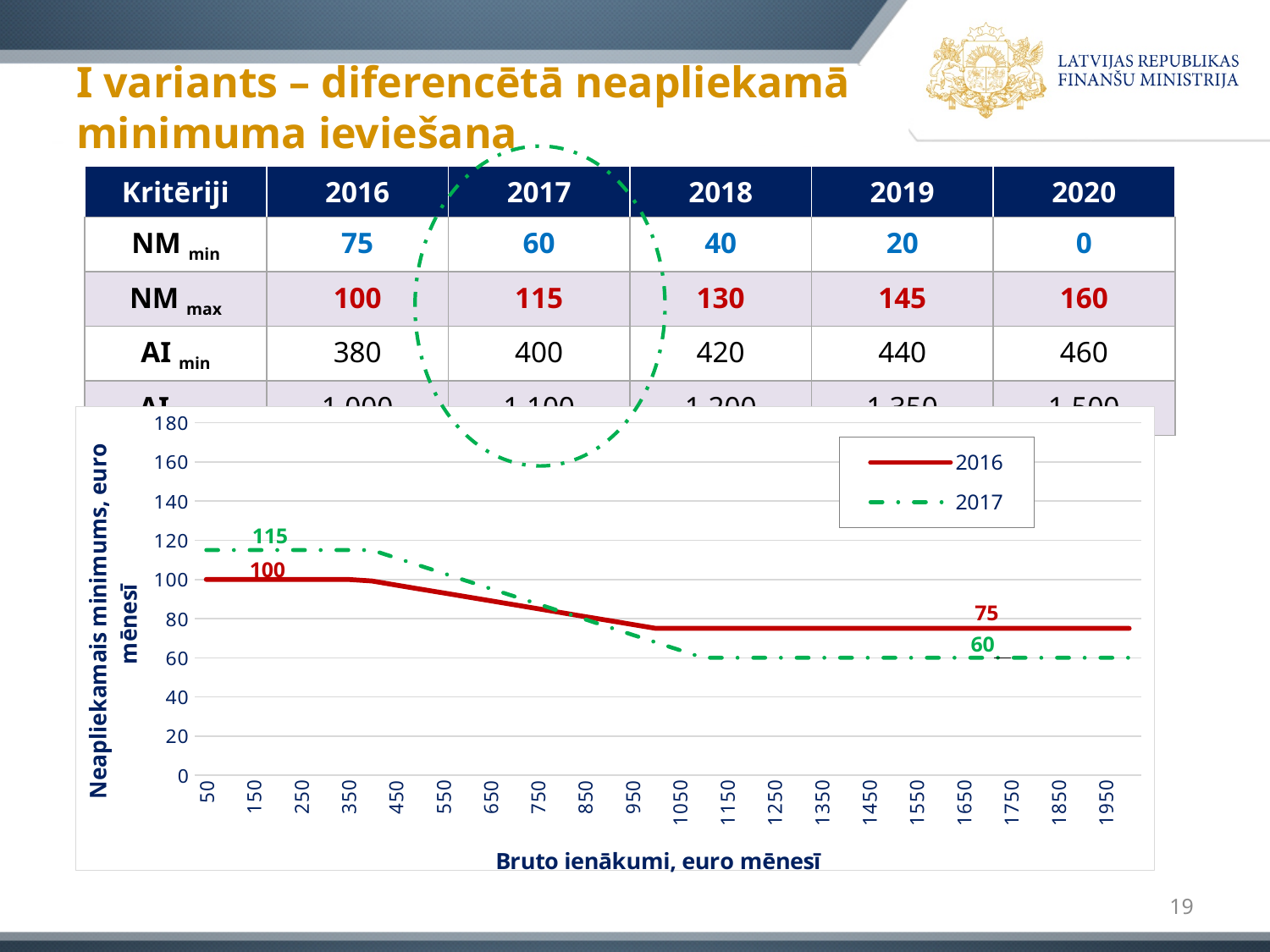
By how much does the 2017 line fall from its labelled starting value (115) to its labelled ending value (60)? 55 What is the labelled value of the 2016 line at the highest income levels? 75 What kind of chart is shown on the slide? line chart At a gross income of 1950 euro per month, which series has the higher value, 2016 or 2017? 2016 What is the labelled value of the 2016 line at the lowest income levels? 100 How many series does the chart legend list? 2 What is the labelled value of the 2017 line at the lowest income levels? 115 At a gross income of 50 euro per month, which series has the higher value, 2016 or 2017? 2017 Do the values of the 2016 line rise or fall as gross income increases along the x axis? fall What is the difference between the labelled starting values of the 2017 line (115) and the 2016 line (100)? 15 What is the title of the x axis of the chart? Bruto ienākumi, euro mēnesī What is the labelled value of the 2017 line at the highest income levels? 60